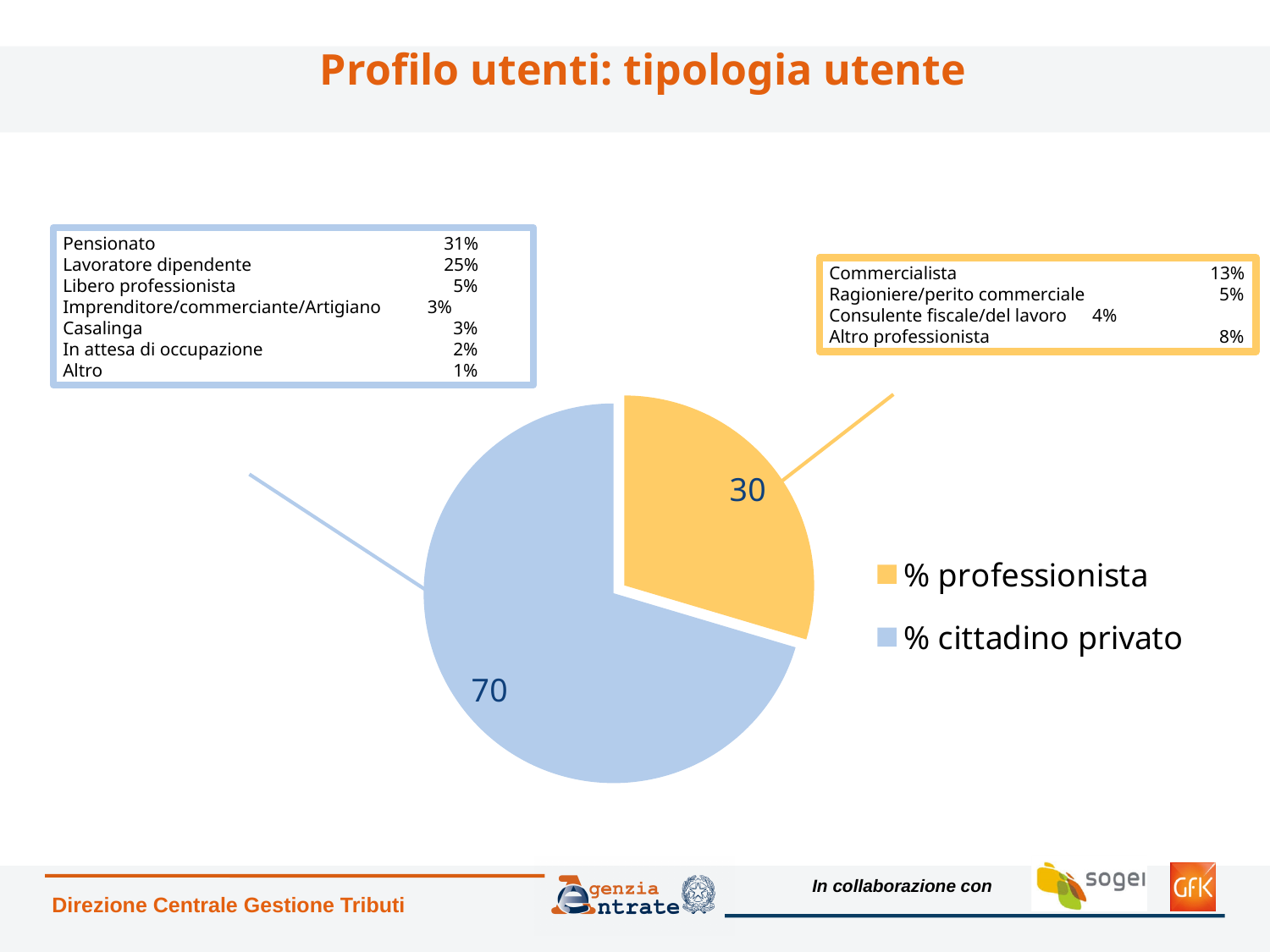
How many slices does the pie chart have? 2 What is the value for % professionista in the pie chart? 30 What share of the pie does the % professionista slice represent? 30 Which slice of the pie chart is the smallest? % professionista What kind of chart is shown on the slide? pie chart Which is larger in the pie chart, % professionista or % cittadino privato? % cittadino privato How many entries does the legend of the pie chart list? 2 What is the value for % cittadino privato in the pie chart? 70 Which slice of the pie chart is the largest? % cittadino privato What colour is the % professionista slice in the pie chart? yellow/orange What colour is the % cittadino privato slice in the pie chart? light blue What is the difference between the % cittadino privato and % professionista values in the pie chart? 40